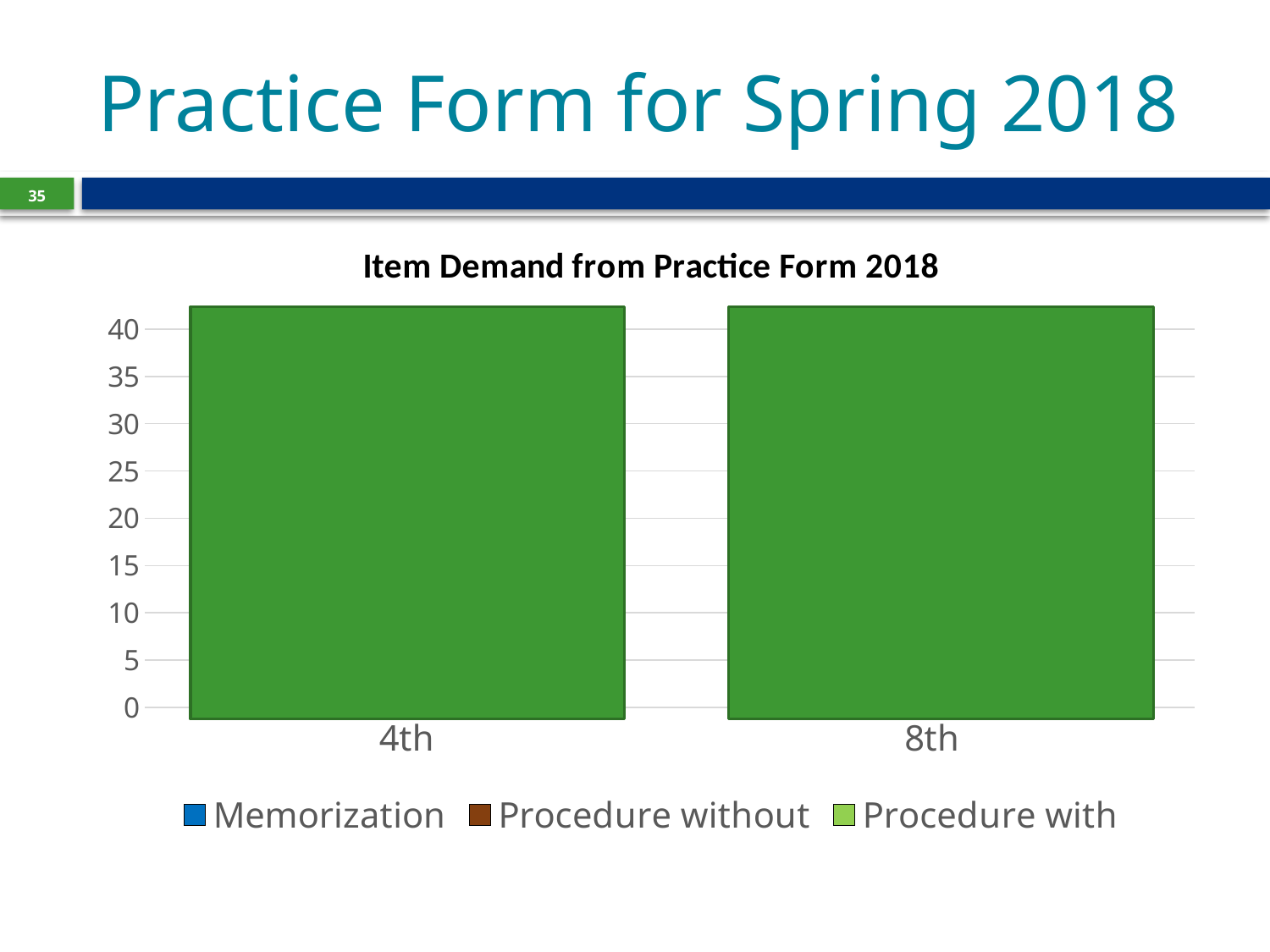
What are the two category labels on the x axis? 4th and 8th How many series does the chart's legend list? 3 Is the value of the bar for 4th greater or less than 40? greater What is the title of the chart? Item Demand from Practice Form 2018 Is the value of the bar for 8th greater or less than 40? greater Is the value of the bar for 8th greater or less than 30? greater What kind of chart is shown on the slide? bar chart How many categories are shown on the x axis of the chart? 2 Which series in the legend is shown in green? Procedure with